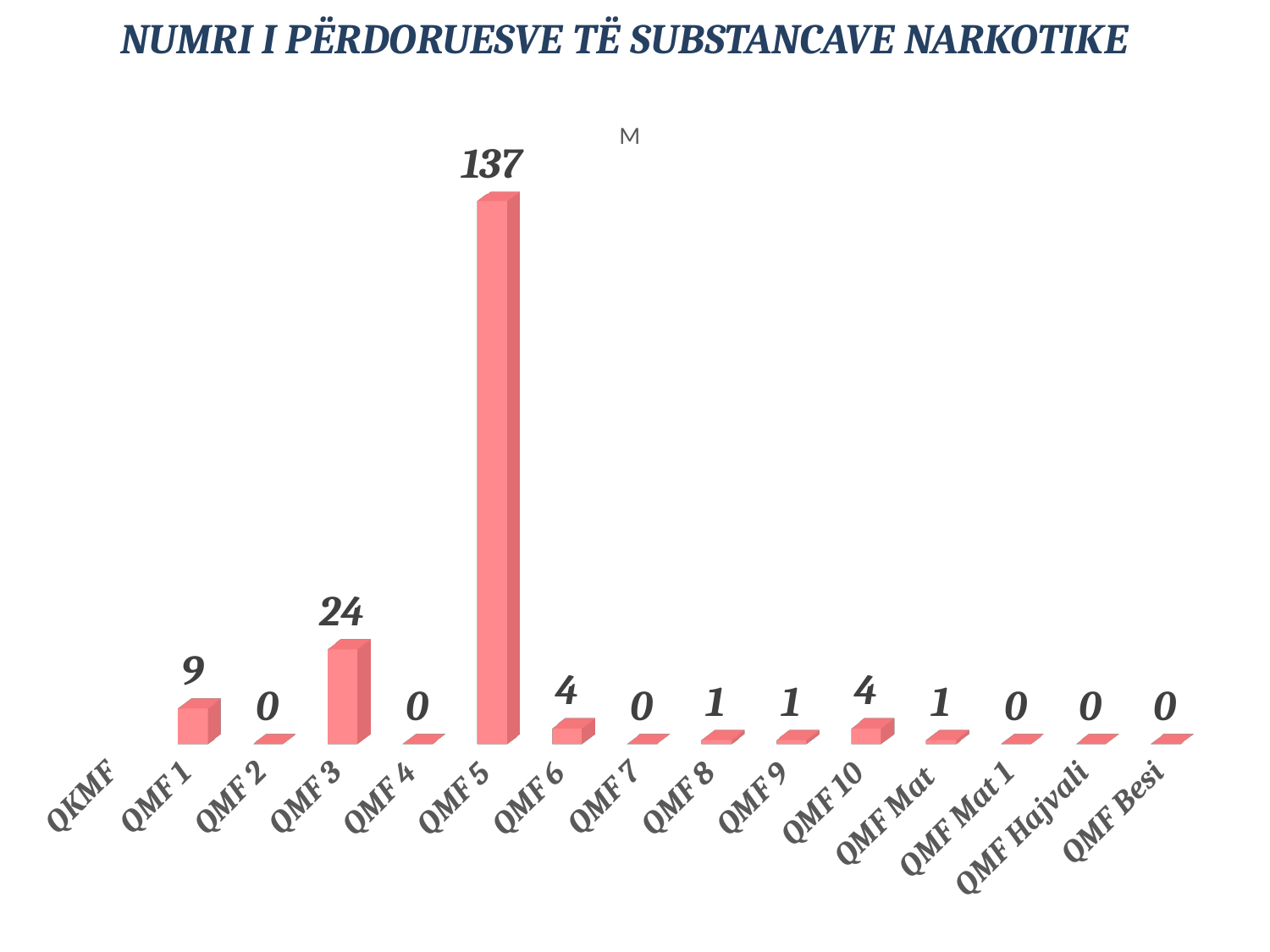
What is the value for QMF Besi? 0 What is the value for QMF 3? 24 What is the value for QMF 10? 4 What is the difference between the values for QMF 5 and QMF 3? 113 What is the difference between the values for QMF 3 and QMF 1? 15 What is the value for QMF 5? 137 What is the value for QMF 6? 4 Which is larger, the value for QMF 3 or the value for QMF 1? QMF 3 What is the value for QMF 1? 9 Which category has the highest value? QMF 5 What is the title of the chart? NUMRI I PËRDORUESVE TË SUBSTANCAVE NARKOTIKE What kind of chart is shown on the slide? bar chart